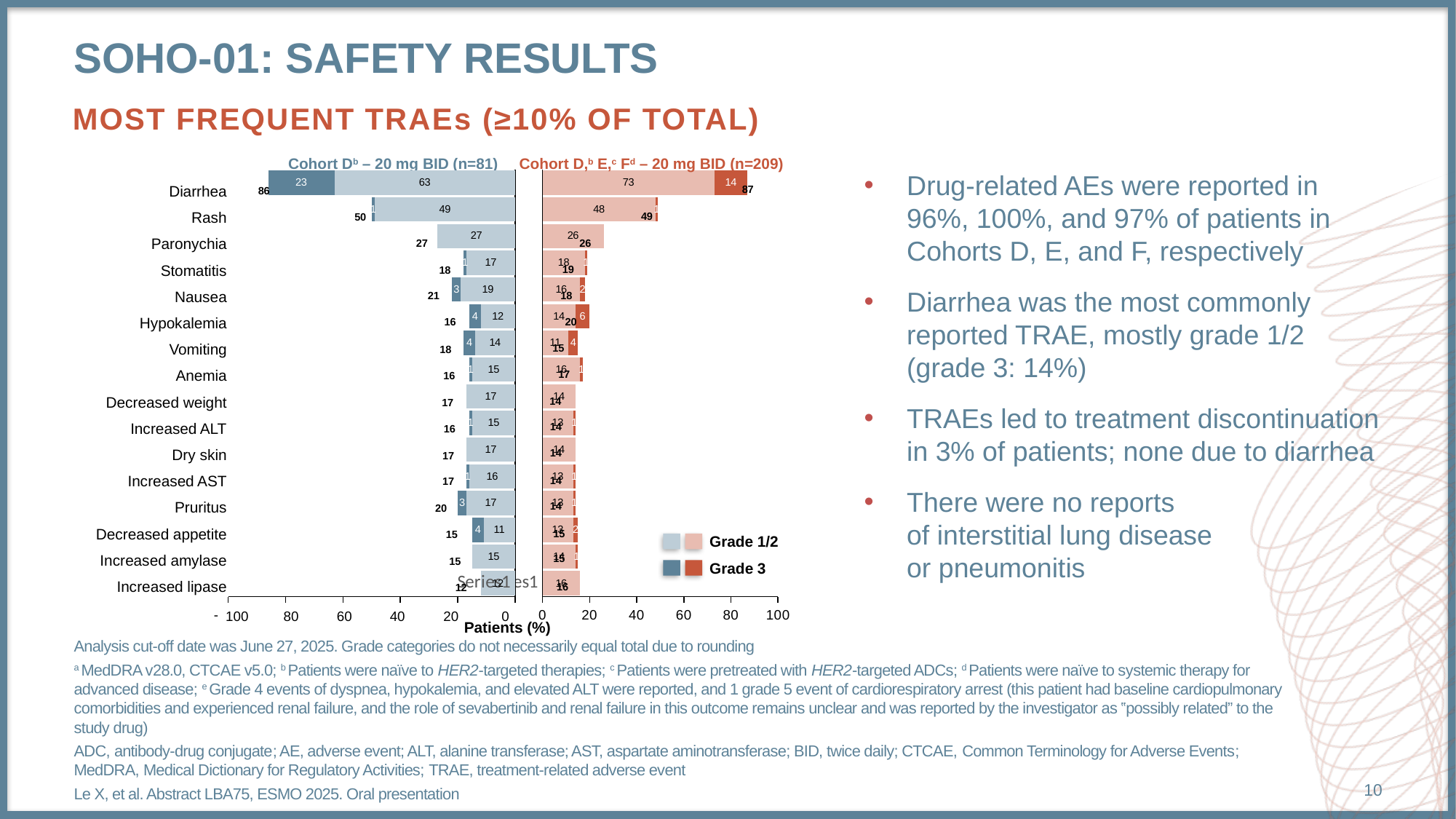
Which TRAE has the lowest total percentage in Cohort D (n=81)? Increased lipase What is the total percentage of patients with diarrhea in Cohorts D, E, F (20 mg BID, n=209)? 87 What type of chart is used to show the most frequent TRAEs? Bar chart How many TRAE categories are listed on the chart? 16 What is the grade 3 percentage for diarrhea in Cohorts D, E, F (n=209)? 14 How many grade categories does the legend list? 2 What is the grade 3 percentage for diarrhea in Cohort D (n=81)? 23 Which TRAE has the highest total percentage in Cohort D (n=81)? Diarrhea Which is larger in Cohorts D, E, F (n=209): the total percentage for hypokalemia or for vomiting? Hypokalemia What is the difference between the total percentages for diarrhea and rash in Cohort D (n=81)? 36 What is the total percentage for rash in Cohort D (n=81)? 50 What is the total percentage of patients with diarrhea in Cohort D (20 mg BID, n=81)? 86